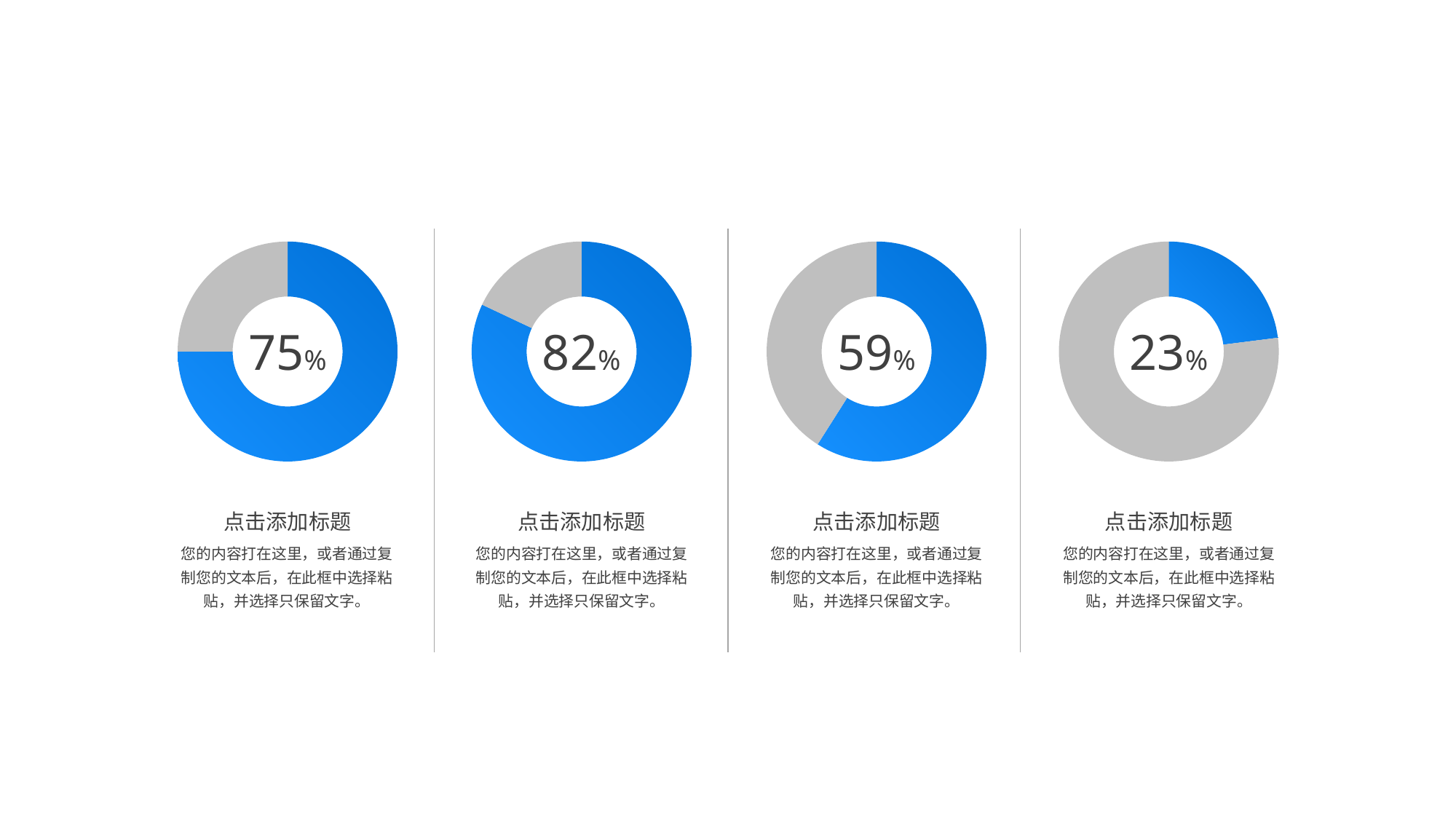
Which is larger: the percentage in the leftmost donut chart or the percentage in the third donut chart from the left? The leftmost (75%) Which of the four donut charts shows the lowest percentage? The rightmost (23%) What percentage is shown in the centre of the second donut chart from the left? 82% What percentage is shown in the centre of the rightmost donut chart? 23% What kind of chart is used for each of the four figures on the slide? Donut chart In the rightmost donut chart, is the blue portion greater or less than 50% of the ring? less What colour is used for the filled (percentage) portion of each donut chart? Blue What is the difference between the percentage in the second donut chart (82%) and the percentage in the rightmost donut chart (23%)? 59% Which of the four donut charts shows the highest percentage? The second from the left (82%) What percentage is shown in the centre of the leftmost donut chart? 75% How many donut charts are on the slide? 4 What percentage is shown in the centre of the third donut chart from the left? 59%